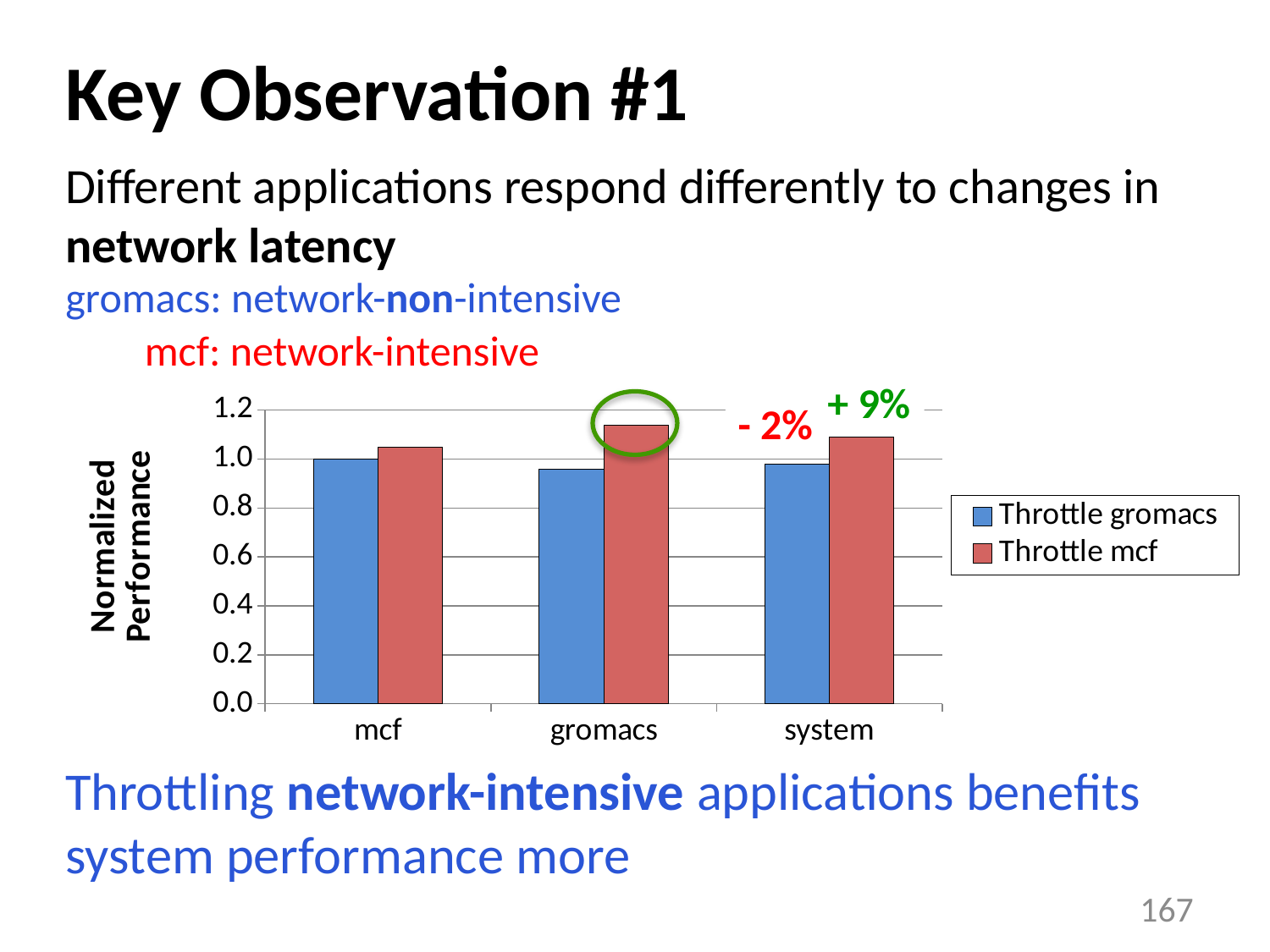
For system, which series has the larger bar, Throttle gromacs or Throttle mcf? Throttle mcf Is the Throttle mcf value for gromacs greater or less than 1.0? greater What are the two series named in the chart's legend? Throttle gromacs and Throttle mcf What kind of chart is shown on the slide? bar chart Is the Throttle gromacs value for gromacs greater or less than 1.0? less How many categories are shown on the x axis of the chart? 3 What is the label on the chart's y axis? Normalized Performance Is the Throttle mcf value for system greater or less than 1.0? greater What percentage change is annotated above the Throttle mcf bar for system? + 9% For gromacs, which series has the larger bar, Throttle gromacs or Throttle mcf? Throttle mcf In which category does the Throttle mcf series reach its highest value? gromacs How many series does the chart's legend list? 2